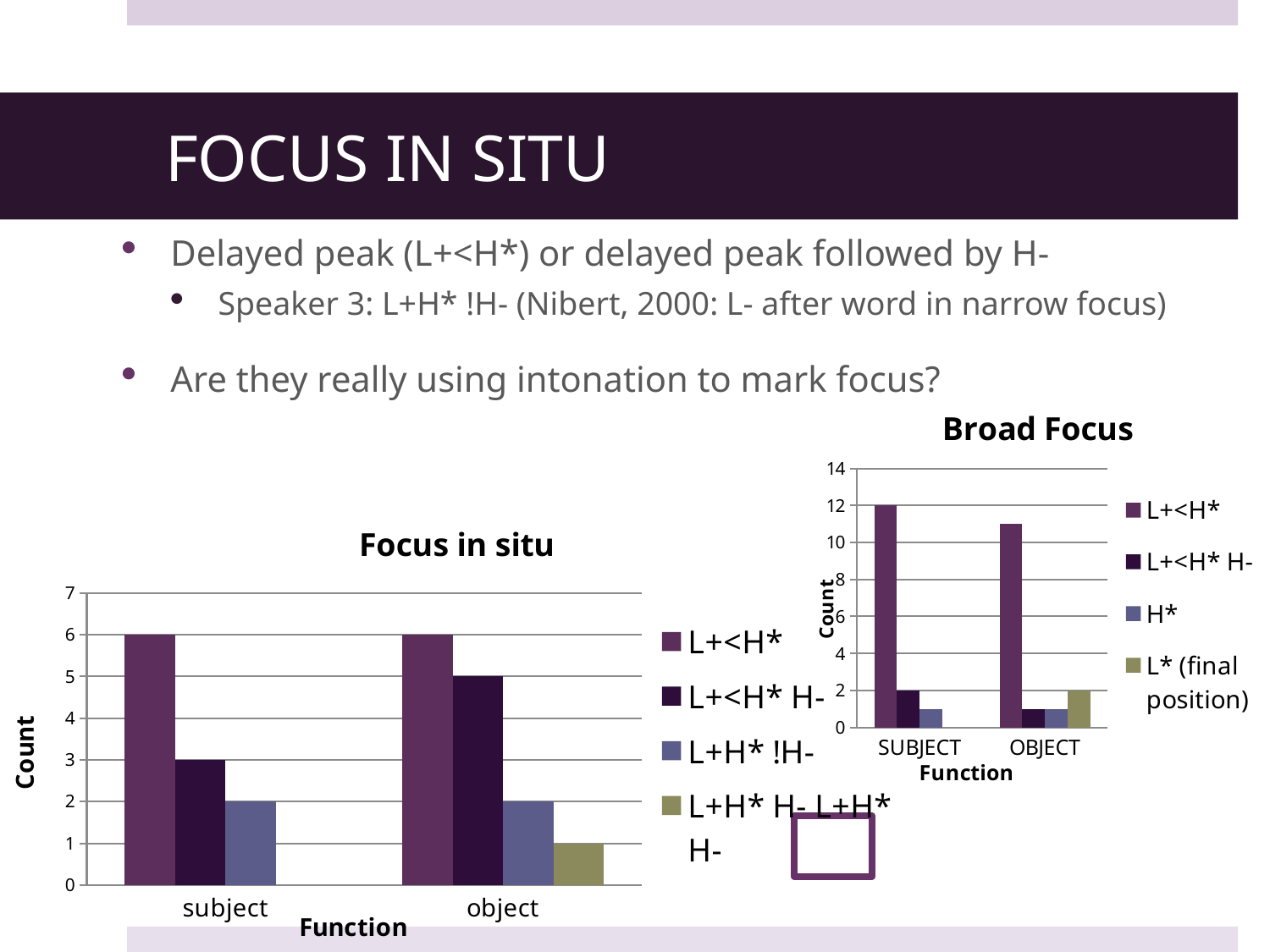
In the "Focus in situ" chart, what is the count for L+<H* in the subject category? 6 How many series does the legend of the "Focus in situ" chart list? 4 In the "Broad Focus" chart, what is the count for L+<H* in the SUBJECT category? 12 In the "Broad Focus" chart, which series has the highest count for SUBJECT? L+<H* In the "Focus in situ" chart, is the L+<H* H- count larger for subject or for object? object In the "Broad Focus" chart, is the value for L+<H* in the OBJECT category greater or less than 10? greater What kind of chart is the "Focus in situ" chart? bar chart In the "Focus in situ" chart, what is the difference between the L+<H* and L+<H* H- counts for object? 1 In the "Focus in situ" chart, what is the count for L+<H* H- in the object category? 5 How many categories are shown on the x axis of the "Broad Focus" chart? 2 In the "Focus in situ" chart, what is the count for L+H* !H- in the subject category? 2 In the "Broad Focus" chart, what is the count for L* (final position) in the OBJECT category? 2